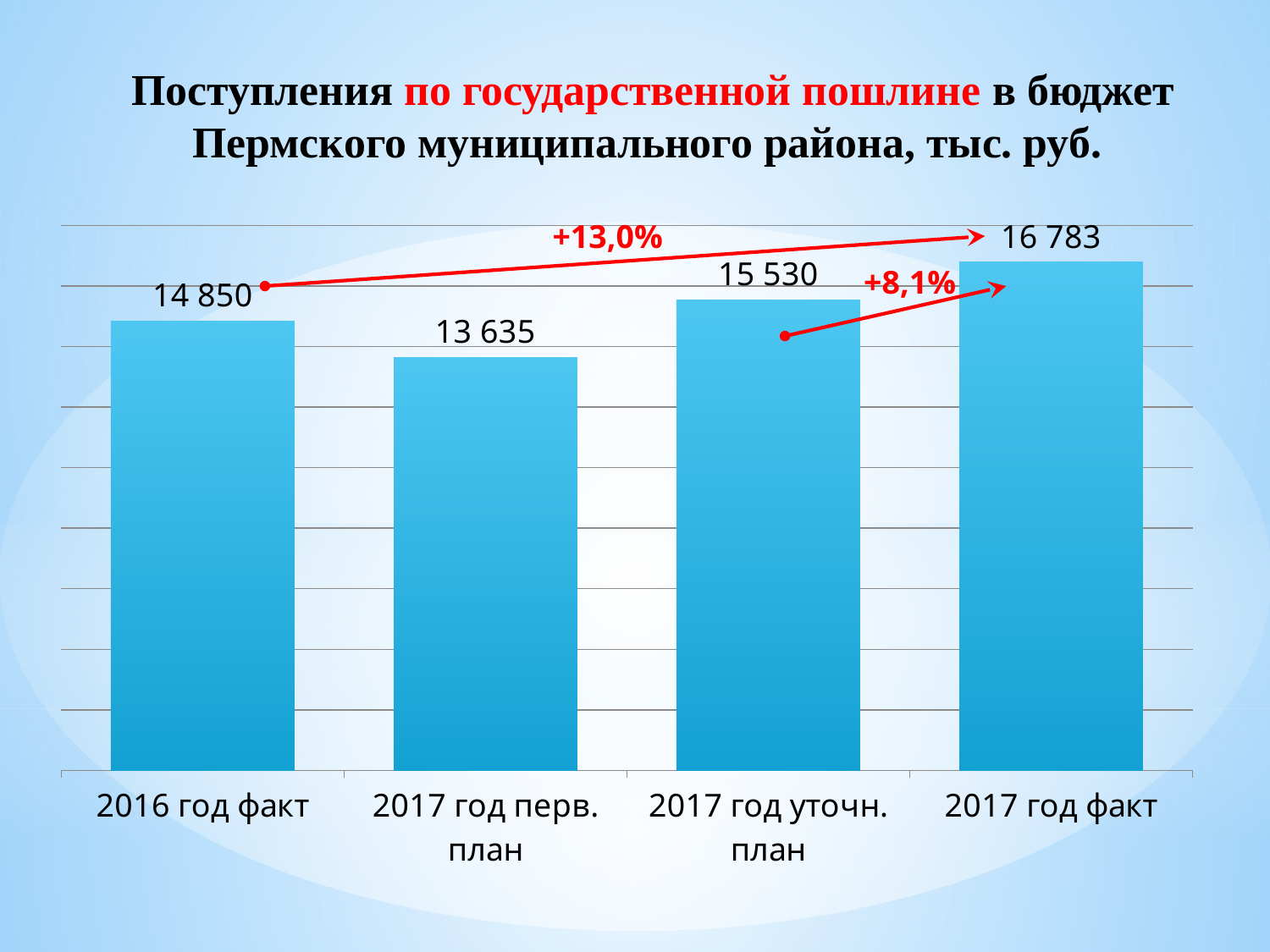
Which is larger, the value for 2016 год факт or the value for 2017 год уточн. план? 2017 год уточн. план What kind of chart is shown on the slide? Bar chart What is the difference between the values for 2017 год факт and 2016 год факт? 1 933 Which category has the lowest value? 2017 год перв. план How many categories are shown on the chart? 4 Which category has the highest value? 2017 год факт What is the value for 2017 год факт? 16 783 What is the value for 2017 год уточн. план? 15 530 What is the value for 2016 год факт? 14 850 What is the difference between the values for 2017 год уточн. план and 2017 год перв. план? 1 895 What percentage change is annotated between 2016 год факт and 2017 год факт? +13,0% What is the value for 2017 год перв. план? 13 635